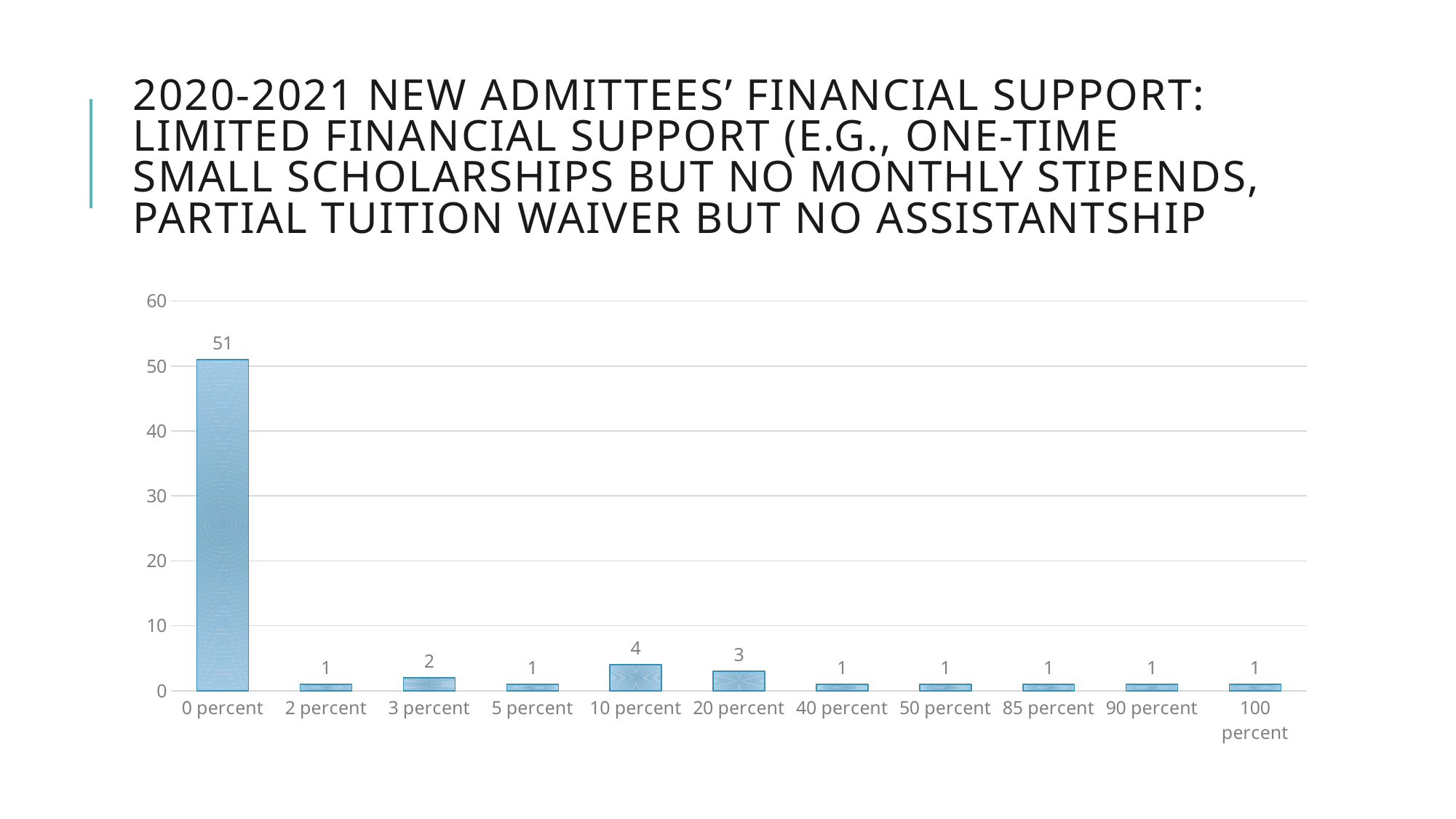
What is the value for the 3 percent category? 2 What is the difference between the values for 0 percent and 10 percent? 47 Which is larger, the value for 10 percent or the value for 20 percent? 10 percent What is the value for the 10 percent category? 4 How many categories are shown on the x axis? 11 What is the value for the 20 percent category? 3 What is the value for the 0 percent category? 51 What is the difference between the values for 10 percent and 20 percent? 1 What kind of chart is shown on the slide? bar chart What is the value for the 100 percent category? 1 Which category has the highest value? 0 percent Is the value for 0 percent greater or less than 40? greater